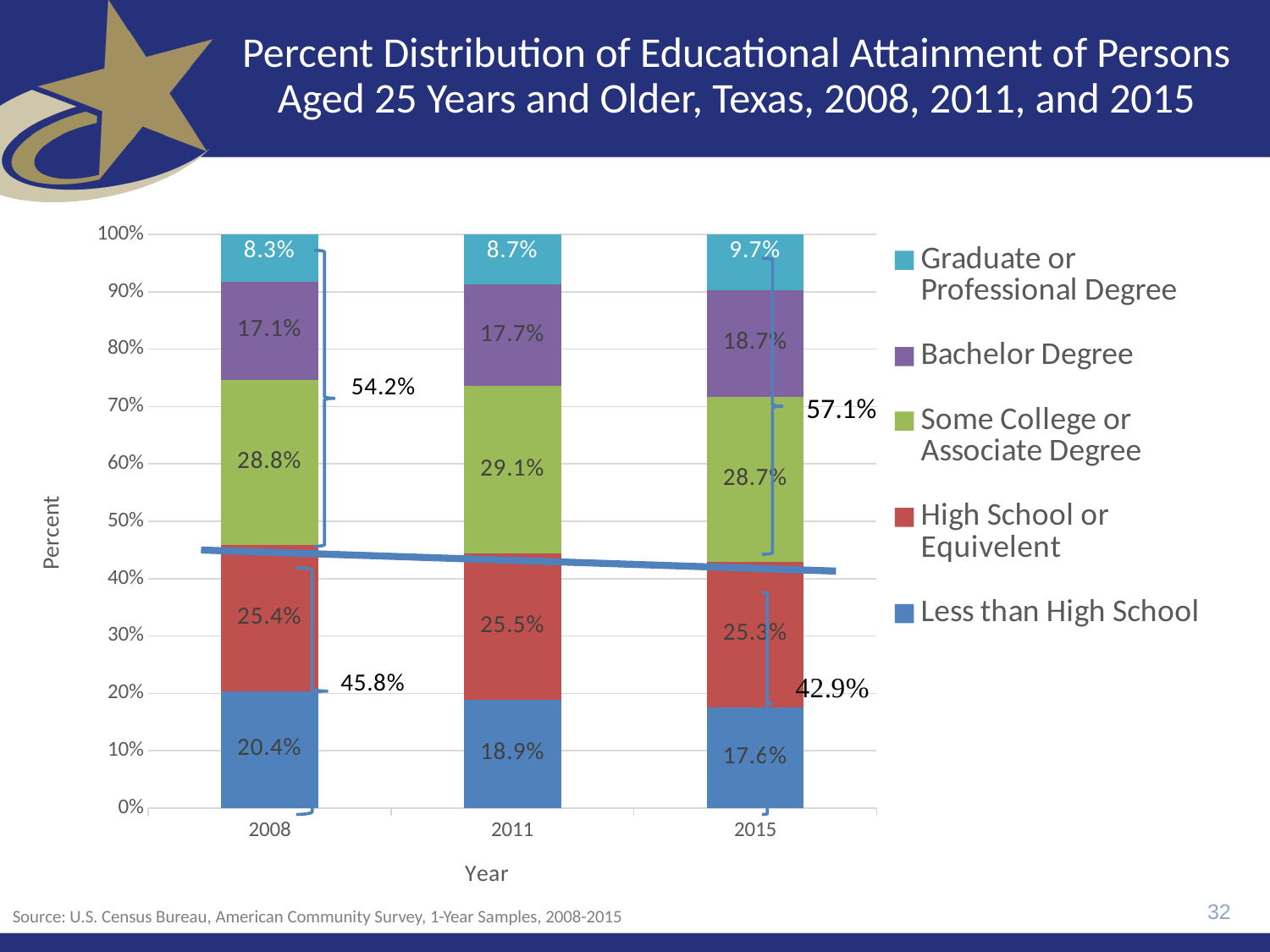
What is the title of the x axis? Year Does the Less than High School share rise or fall from 2008 to 2015? Fall What is the value for Graduate or Professional Degree in 2015? 9.7% How many years are shown on the x axis? 3 What kind of chart is shown on the slide? Stacked bar chart What percentage of persons aged 25 and older in Texas had Less than High School education in 2008? 20.4% Which year has the highest value for Some College or Associate Degree? 2011 Does the Graduate or Professional Degree share rise or fall from 2008 to 2015? Rise What is the value for Bachelor Degree in 2011? 17.7% How many series does the legend list? 5 By how many percentage points did the Bachelor Degree share change from 2008 to 2015? 1.6 percentage points What is the value for High School or Equivelent in 2015? 25.3%